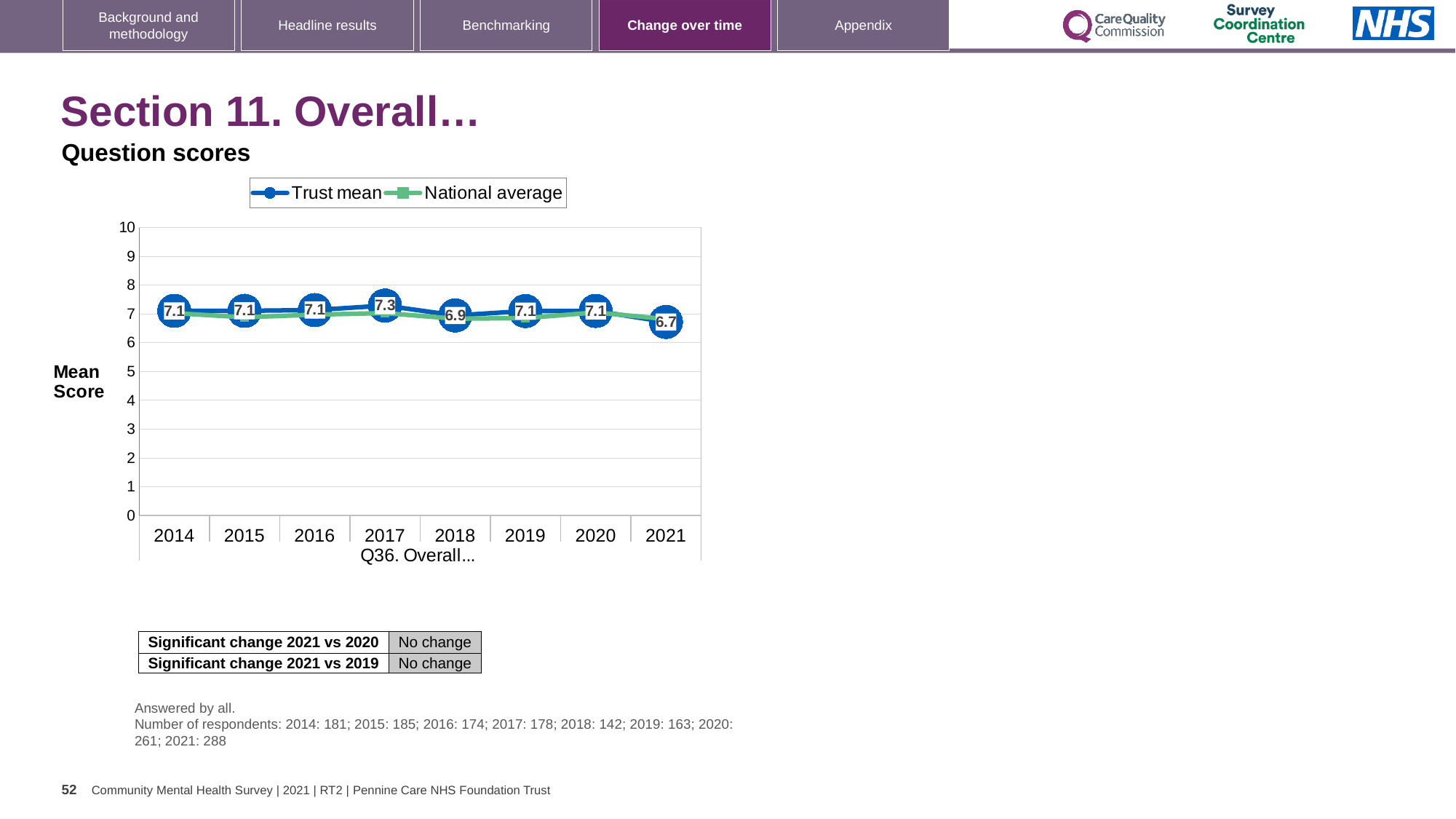
In which year is the Trust mean highest? 2017 How many years are plotted on the x axis? 8 Does the Trust mean rise or fall from 2020 to 2021? Fall What is the Trust mean score for 2021? 6.7 Which year has the larger Trust mean, 2017 or 2018? 2017 What is the Trust mean score for 2017? 7.3 How many series does the legend list? 2 In which year is the Trust mean lowest? 2021 What is the difference between the Trust mean in 2017 and in 2021? 0.6 What kind of chart is shown on the slide? Line chart What is the Trust mean score for 2018? 6.9 Is the National average value for 2021 greater or less than 5? greater